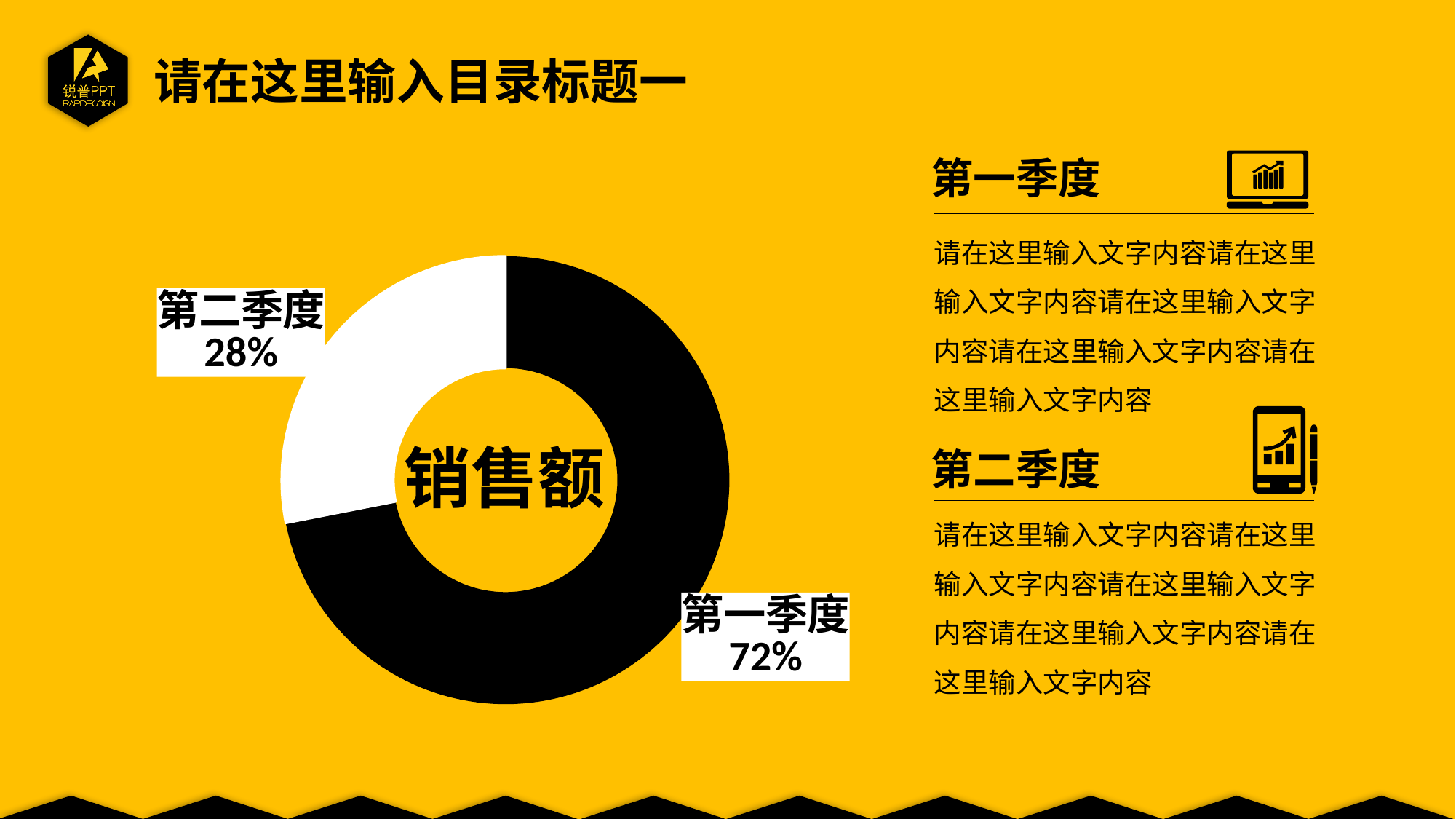
What is the difference in percentage points between 第一季度 and 第二季度? 44 How many segments does the doughnut chart have? 2 Which is larger, the share for 第一季度 or the share for 第二季度? 第一季度 Which segment of the doughnut chart is the smallest? 第二季度 What kind of chart is shown on the slide? Doughnut chart What percentage is shown for 第二季度 in the doughnut chart? 28% What is the total of the two percentages shown in the doughnut chart? 100% Which segment of the doughnut chart is the largest? 第一季度 What colour is the 第一季度 segment of the doughnut chart? Black What text is displayed in the centre of the doughnut chart? 销售额 What percentage is shown for 第一季度 in the doughnut chart? 72%